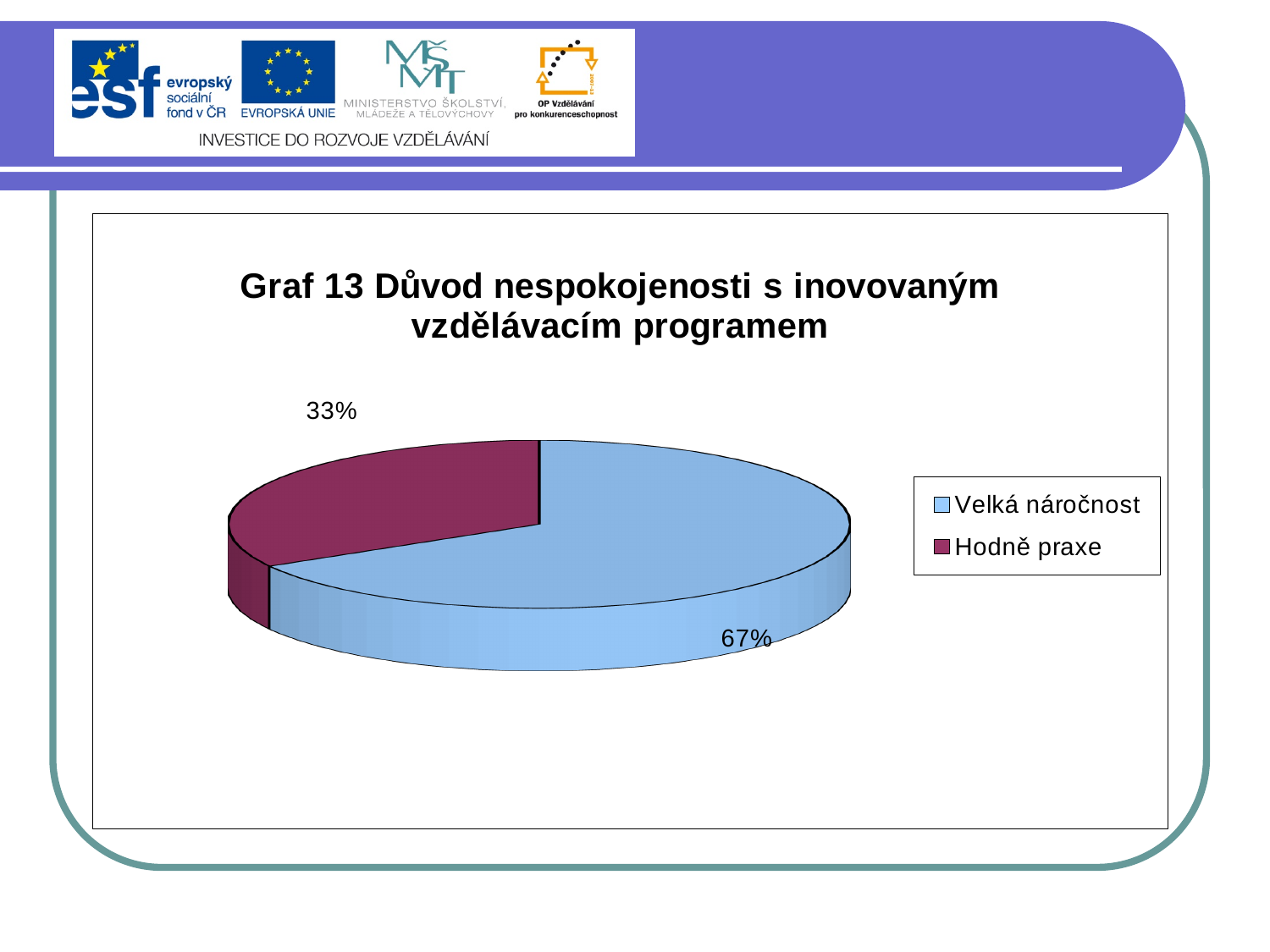
What is the title of the chart? Graf 13 Důvod nespokojenosti s inovovaným vzdělávacím programem Which slice is larger, "Velká náročnost" or "Hodně praxe"? Velká náročnost What is the difference in percentage points between the "Velká náročnost" and "Hodně praxe" slices? 34 What share of the pie does "Velká náročnost" take? 67% Which colour represents "Hodně praxe" in the pie chart? dark red (maroon) What share of the pie does "Hodně praxe" take? 33% How many slices does the pie chart have? 2 Which category has the largest slice of the pie? Velká náročnost How many entries does the legend list? 2 What kind of chart is shown on the slide? pie chart Which category has the smallest slice of the pie? Hodně praxe